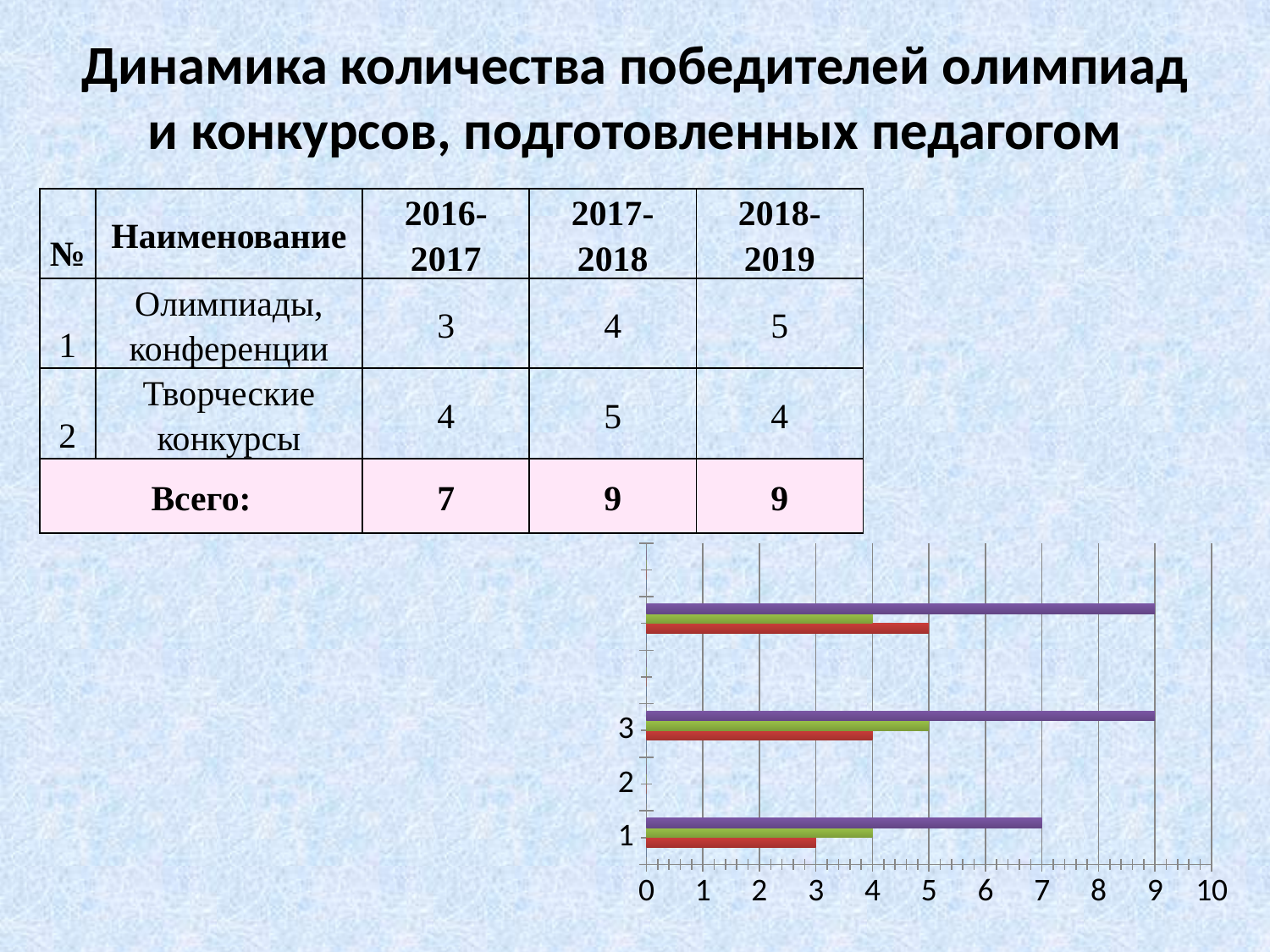
What is the value of the purple bar in the bottom group of the chart? 7 How many groups of bars does the chart show? 3 What is the value of the purple bar in the top group of the chart? 9 How many bars are there in each group of the chart? 3 What kind of chart is shown on the slide? bar chart What is the value of the green bar in the middle group of the chart? 5 What is the value of the red bar in the bottom group of the chart? 3 What is the highest value shown on the chart's horizontal axis? 10 Which colour bar is the shortest in the top group of the chart? green What is the difference between the purple bar and the red bar in the bottom group of the chart? 4 In the bottom group of the chart, which is larger, the red bar or the green bar? green Which colour bar is the longest in the bottom group of the chart? purple